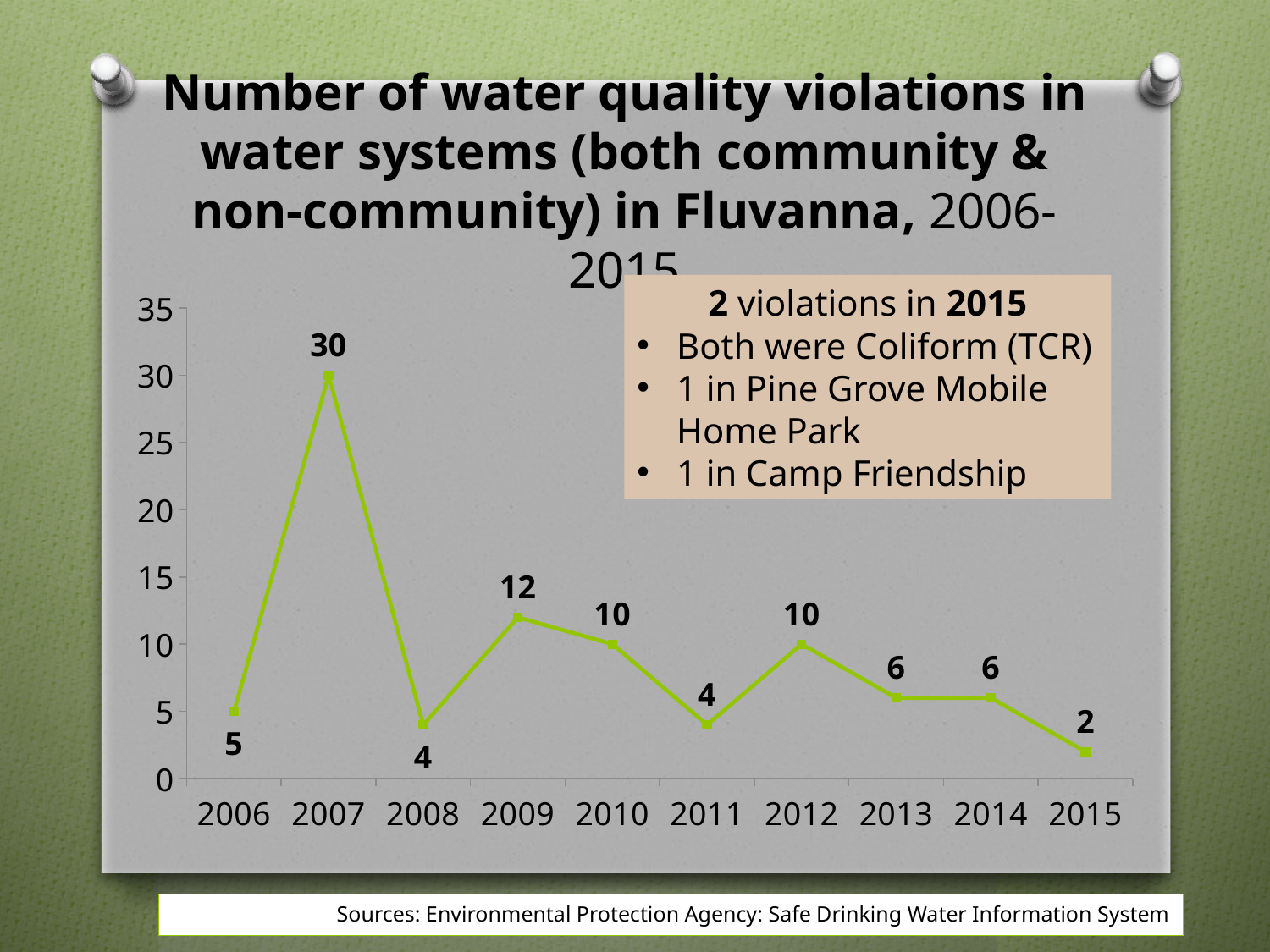
What kind of chart is shown on the slide? Line chart How many water quality violations were there in 2007? 30 Which year had the lowest number of violations? 2015 Do the values rise or fall from 2012 to 2015? Fall How many years are plotted on the chart? 10 How many violations were recorded in 2015? 2 Which year had the highest number of violations? 2007 What is the value for 2009? 12 What is the difference between the values for 2009 and 2011? 8 Which year had more violations, 2006 or 2012? 2012 Is the value for 2007 greater or less than 25? greater What is the difference between the number of violations in 2007 and 2008? 26